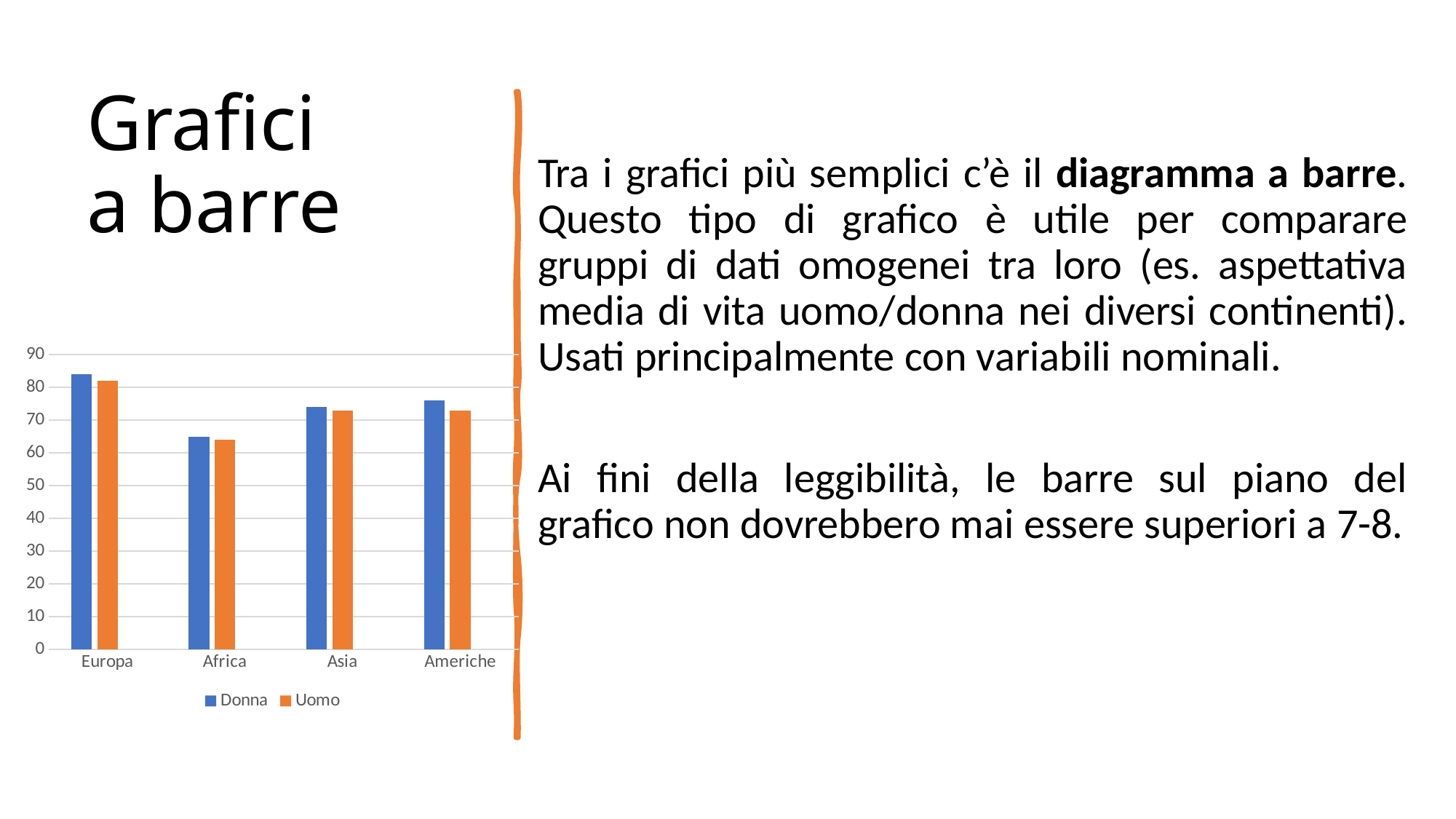
Which is larger, the Donna value for Europa or the Donna value for Asia? Europa Which category has the highest value for the Uomo series? Europa Is the Donna value for Europa greater or less than 80? greater Which series are listed in the chart legend? Donna, Uomo Which category has the lowest value for the Uomo series? Africa Which category has the lowest value for the Donna series? Africa Is the Donna value for Asia greater or less than 70? greater Is the Uomo value for Africa greater or less than 70? less Which category has the highest value for the Donna series? Europa How many series does the chart legend list? 2 How many categories are shown on the x axis of the chart? 4 What kind of chart is shown on the slide? bar chart